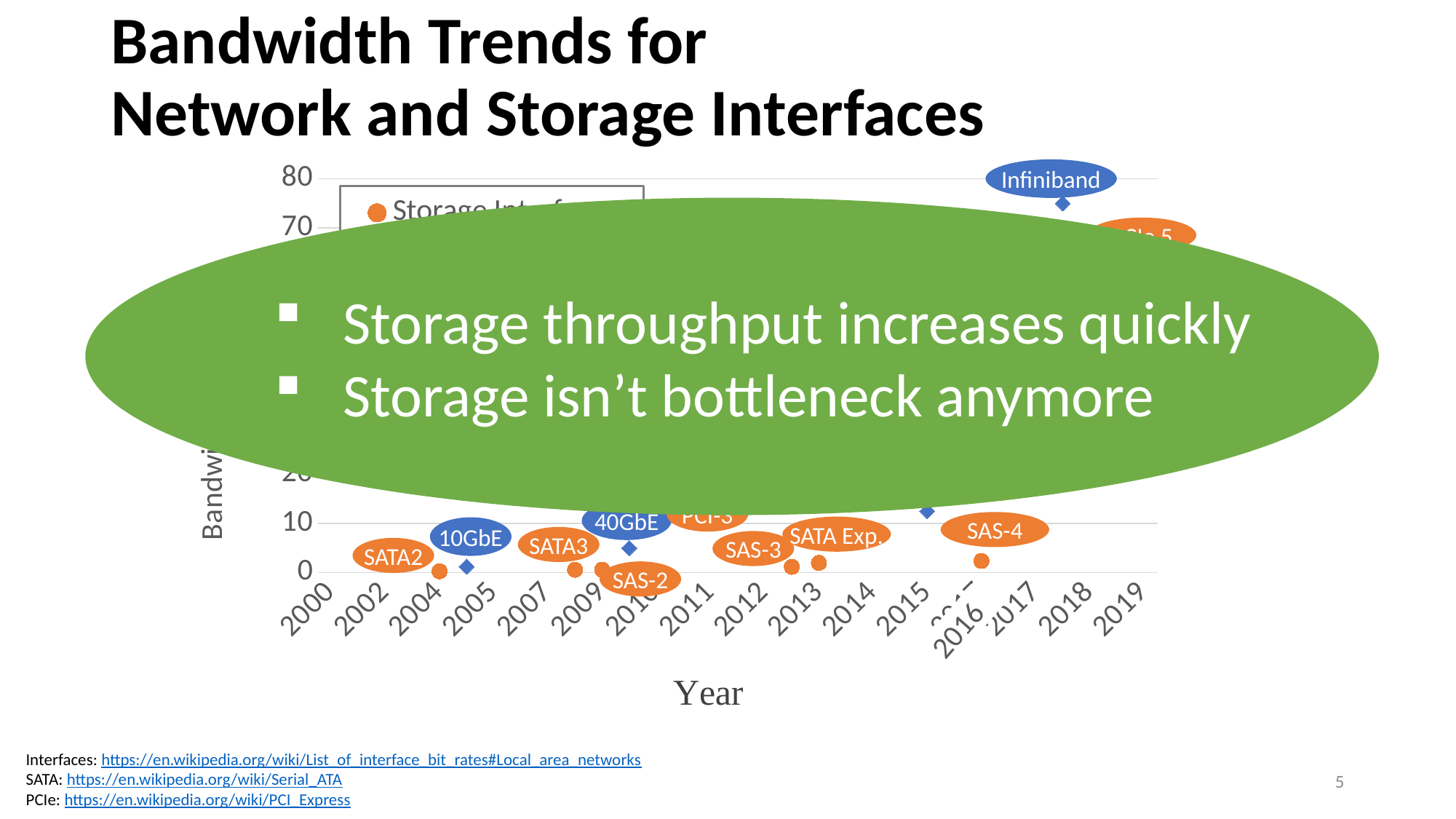
What colour are the markers for the storage interface points (e.g. SATA2, SAS-3)? orange Is the value for 40GbE greater or less than 10? less What is the highest value shown on the y axis of the chart? 80 Is the value for SATA2 greater or less than 10? less Which has the higher value, 40GbE or SAS-2? 40GbE What kind of chart is shown on the slide? scatter chart Is the value for Infiniband greater or less than 70? greater What is the title of the x axis of the chart? Year Which has the higher value, Infiniband or SATA3? Infiniband